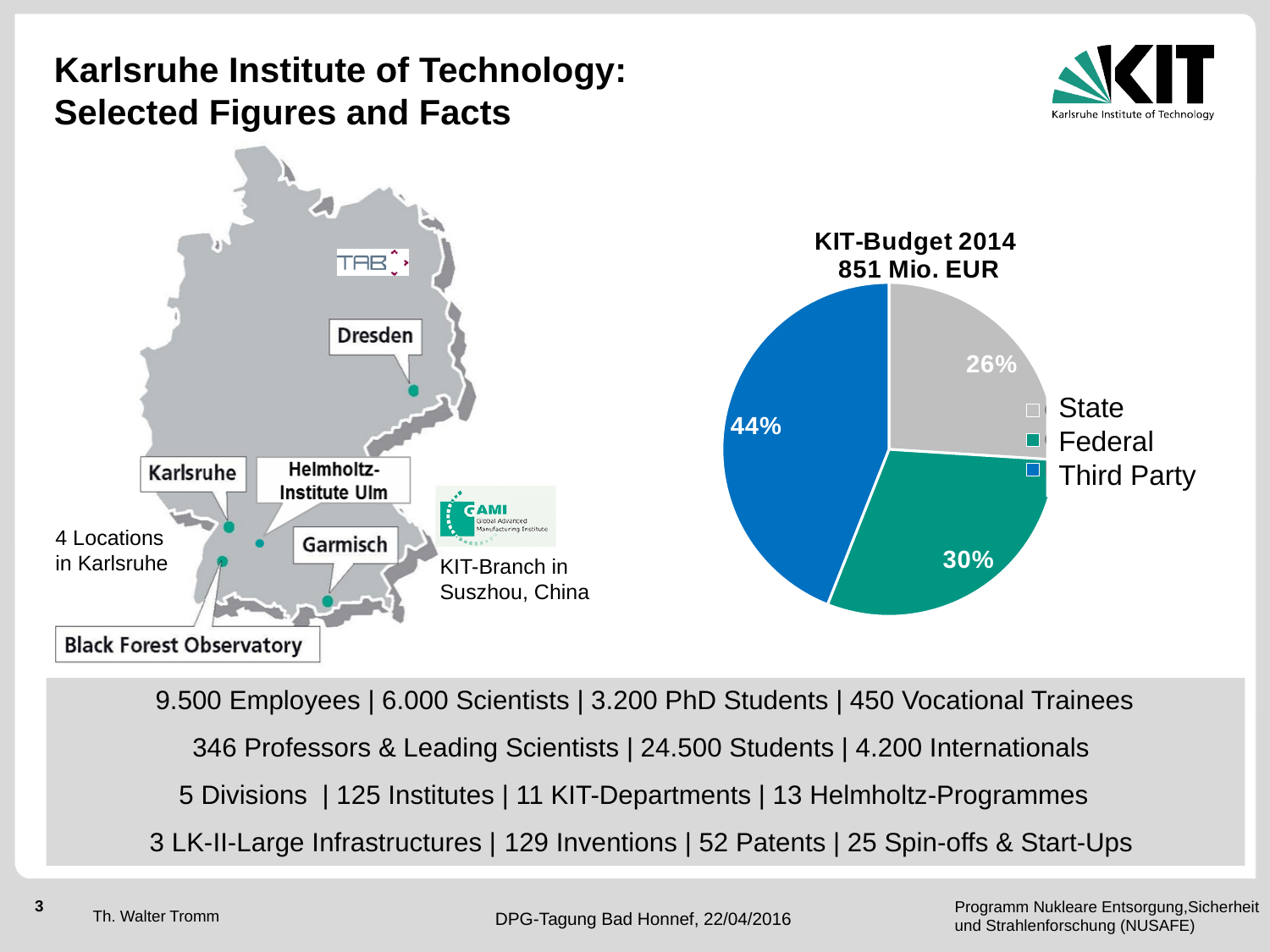
What kind of chart is shown on the slide? pie chart By how many percentage points does the Third Party share exceed the State share in the KIT budget 2014? 18 What is the title of the pie chart? KIT-Budget 2014 851 Mio. EUR Which is larger in the KIT budget 2014, the Federal share or the State share? Federal What share of the KIT budget 2014 comes from Third Party funding? 44% How many entries does the legend of the pie chart list? 3 Which funding source makes up the smallest share of the KIT budget 2014? State What share of the KIT budget 2014 comes from the State? 26% What share of the KIT budget 2014 comes from Federal funding? 30% How many slices does the KIT budget pie chart have? 3 Which funding source makes up the largest share of the KIT budget 2014? Third Party What is the total KIT budget for 2014 as stated in the chart title? 851 Mio. EUR